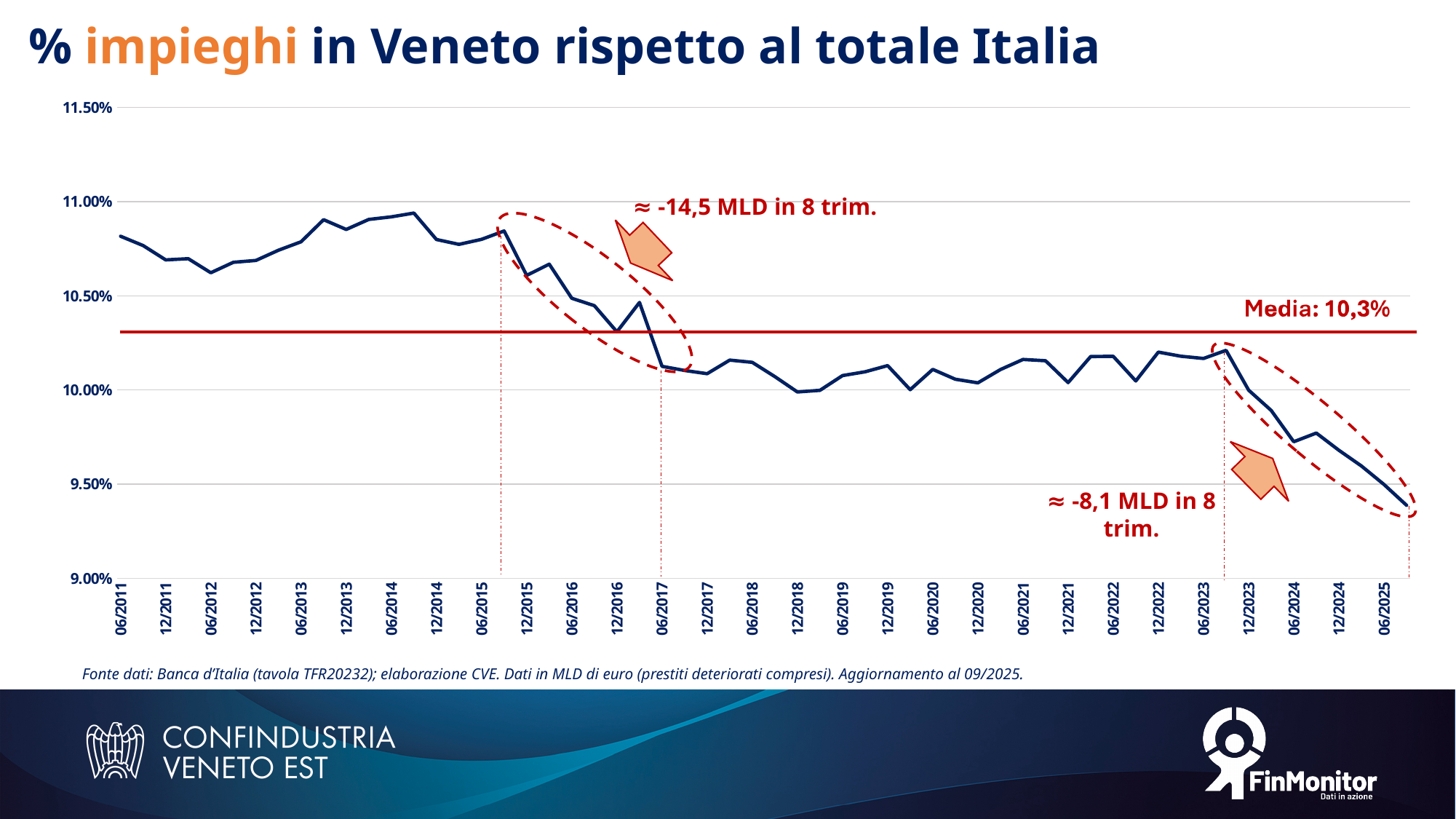
What value does the horizontal red 'Media' line indicate? 10,3% According to the annotation, how much did the value fall in the 8 quarters after 06/2023? ≈ -8,1 MLD Is the value for 06/2014 greater or less than 10.50%? greater Is the value for 06/2011 greater or less than 10.50%? greater Is the value for 12/2018 greater or less than 10.50%? less What is the title of the chart? % impieghi in Veneto rispetto al totale Italia Which is larger, the value for 06/2015 or the value for 06/2017? 06/2015 What kind of chart is shown on the slide? Line chart Overall, does the line rise or fall from 06/2011 to 06/2025? Fall According to the annotation, how much did the value fall in the 8 quarters after 06/2015? ≈ -14,5 MLD